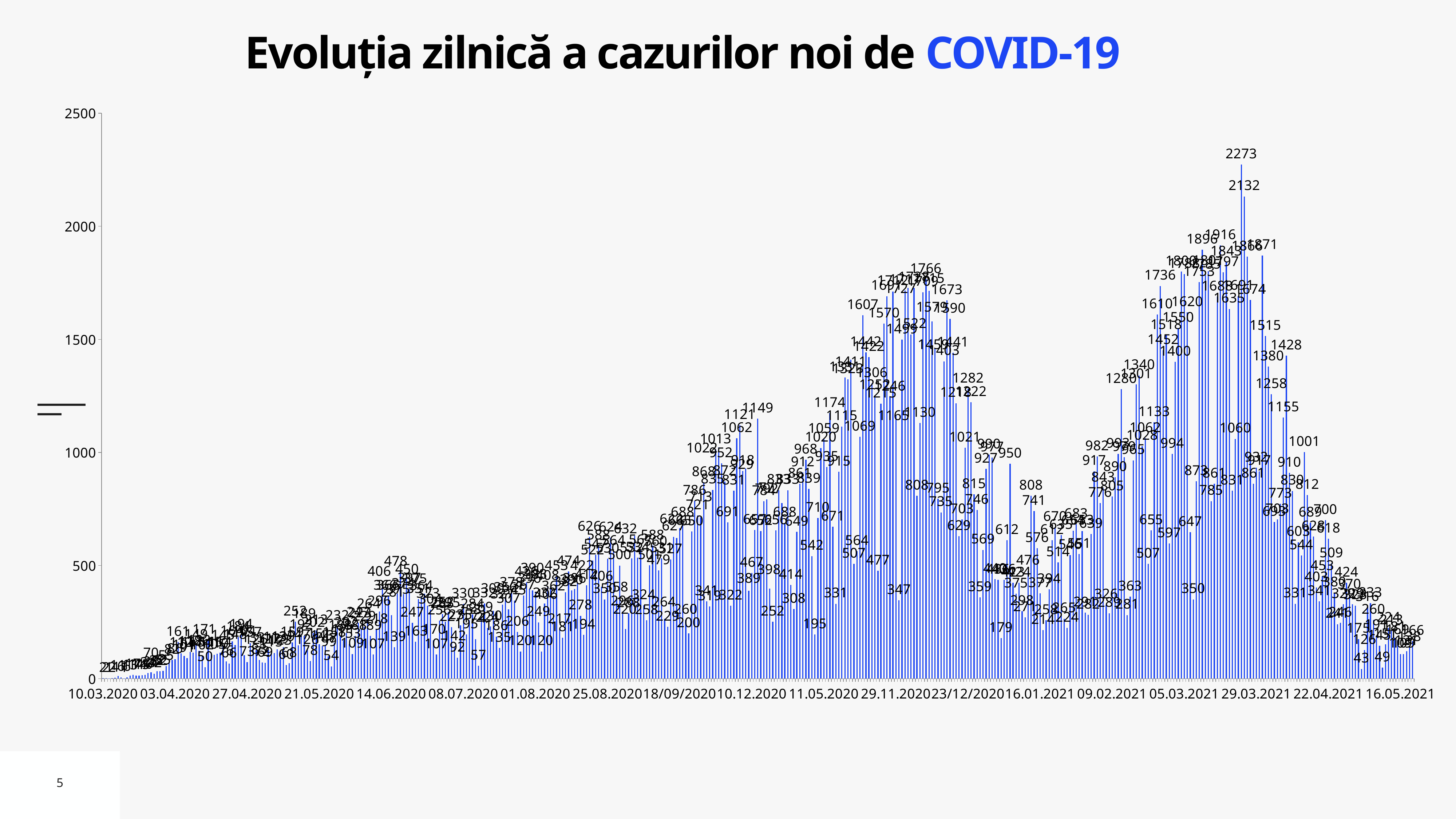
What is the last date label on the horizontal axis? 16.05.2021 Which is larger: the peak of the late-2020 wave labelled 1766 or the peak of the 2021 wave labelled 2273? 2273 What is the second-highest daily value labelled on the chart, just after the 2273 peak? 2132 What is the title of the chart? Evoluția zilnică a cazurilor noi de COVID-19 What is the highest value shown on the vertical axis? 2500 What is the highest daily value labelled on the chart? 2273 Is the highest bar on the chart greater or less than 2000? greater Do the values rise or fall from the start of the chart (10.03.2020) to the first peak around 14.06.2020? rise Is the bar labelled 57 near 08.07.2020 greater or less than 500? less What kind of chart is shown on the slide? bar chart What is the difference between the two highest labelled values, 2273 and 2132? 141 What is the first date label on the horizontal axis? 10.03.2020